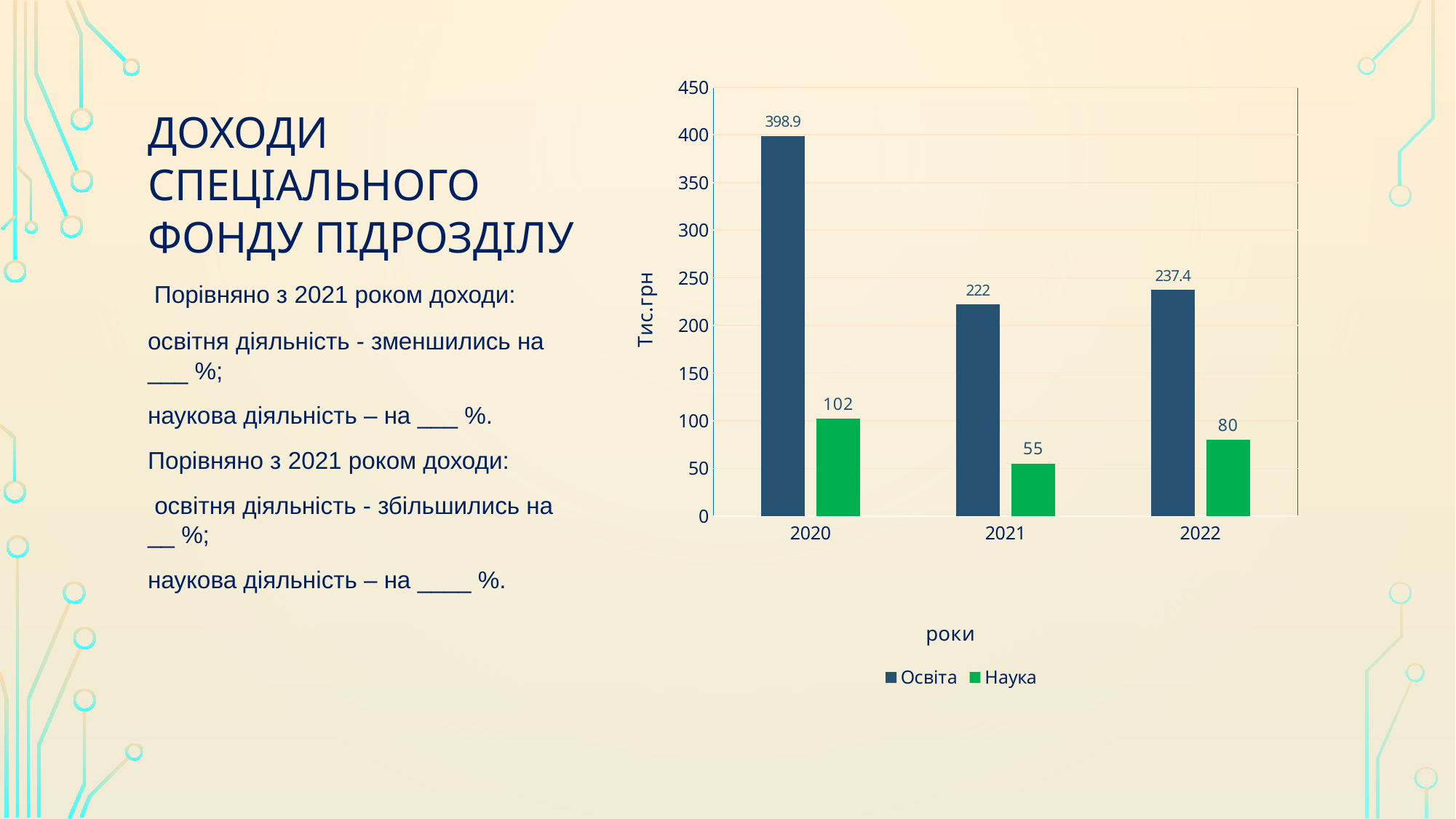
What is the difference between the Наука values for 2020 and 2022? 22 How many series does the legend list? 2 Which is larger, the Освіта value for 2021 or for 2022? 2022 What is the label of the vertical axis? Тис.грн In which year is the value for Освіта highest? 2020 What kind of chart is shown on the slide? bar chart How many years are shown on the x axis? 3 What is the value for Наука in 2021? 55 What is the value for Освіта in 2020? 398.9 In which year is the value for Наука lowest? 2021 What is the difference between the Освіта values for 2020 and 2021? 176.9 What is the value for Освіта in 2022? 237.4